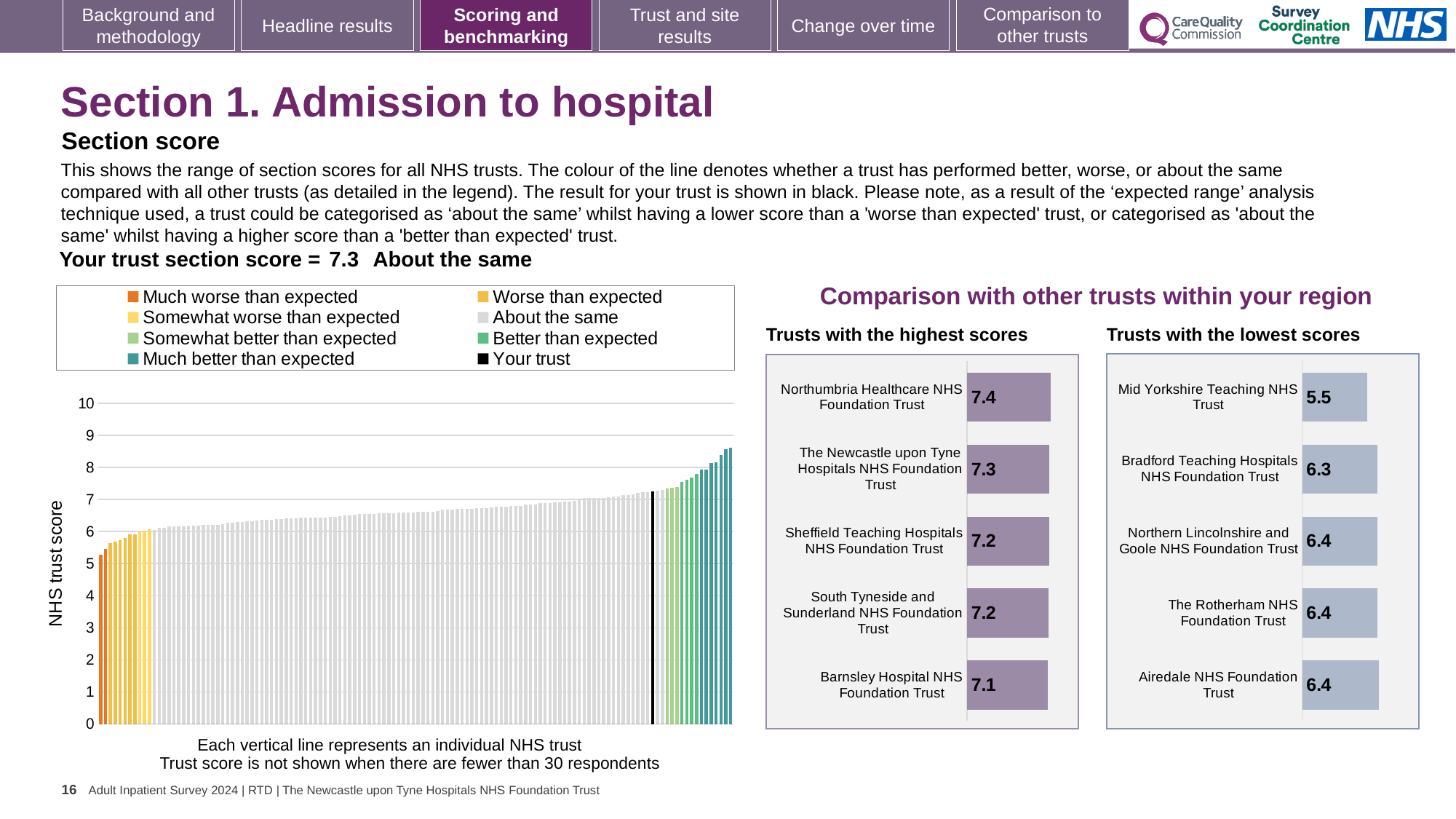
In the 'Trusts with the lowest scores' chart, what is the score for Mid Yorkshire Teaching NHS Trust? 5.5 In the 'Trusts with the highest scores' chart, what is the difference between the scores of Northumbria Healthcare NHS Foundation Trust and Barnsley Hospital NHS Foundation Trust? 0.3 In the main 'NHS trust score' chart on the left, is the value of the tallest bar greater or less than 8? greater How many trusts are shown in the 'Trusts with the highest scores' chart? 5 In the main 'NHS trust score' chart on the left, how many entries does the legend list? 8 In the 'Trusts with the highest scores' chart, what is the score for Northumbria Healthcare NHS Foundation Trust? 7.4 In the 'Trusts with the highest scores' chart, what is the score for Barnsley Hospital NHS Foundation Trust? 7.1 In the 'Trusts with the lowest scores' chart, which trust has the lowest score? Mid Yorkshire Teaching NHS Trust In the 'Trusts with the lowest scores' chart, which has the larger score: Bradford Teaching Hospitals NHS Foundation Trust or Mid Yorkshire Teaching NHS Trust? Bradford Teaching Hospitals NHS Foundation Trust What kind of chart is the main 'NHS trust score' chart on the left? bar chart In the 'Trusts with the highest scores' chart, which trust has the highest score? Northumbria Healthcare NHS Foundation Trust In the 'Trusts with the lowest scores' chart, what is the difference between the scores of Bradford Teaching Hospitals NHS Foundation Trust and Mid Yorkshire Teaching NHS Trust? 0.8